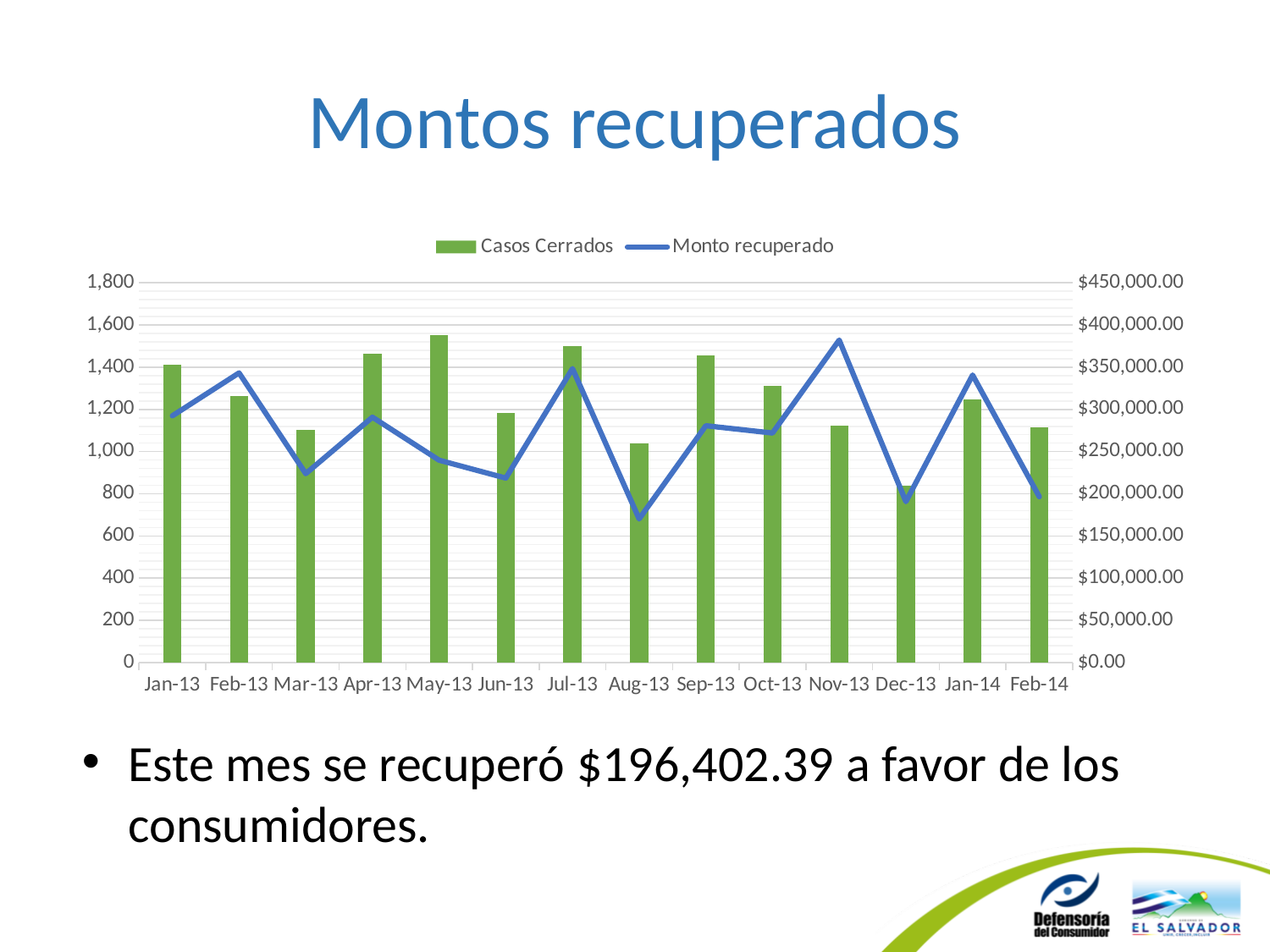
What kind of chart is shown on the slide? A combined bar and line chart Is the number of Casos Cerrados for Dec-13 greater or less than 1,000? less Which month has the lowest Monto recuperado? Aug-13 Which month has more Casos Cerrados, Jul-13 or Aug-13? Jul-13 How many series does the legend list? 2 Which month has the highest Monto recuperado? Nov-13 Which series is drawn as a line in the chart? Monto recuperado Which month has the highest number of Casos Cerrados? May-13 Is the Monto recuperado for Nov-13 greater or less than $350,000.00? greater Which month has the lowest number of Casos Cerrados? Dec-13 Is the Monto recuperado for Aug-13 greater or less than $200,000.00? less How many months are shown on the x axis? 14